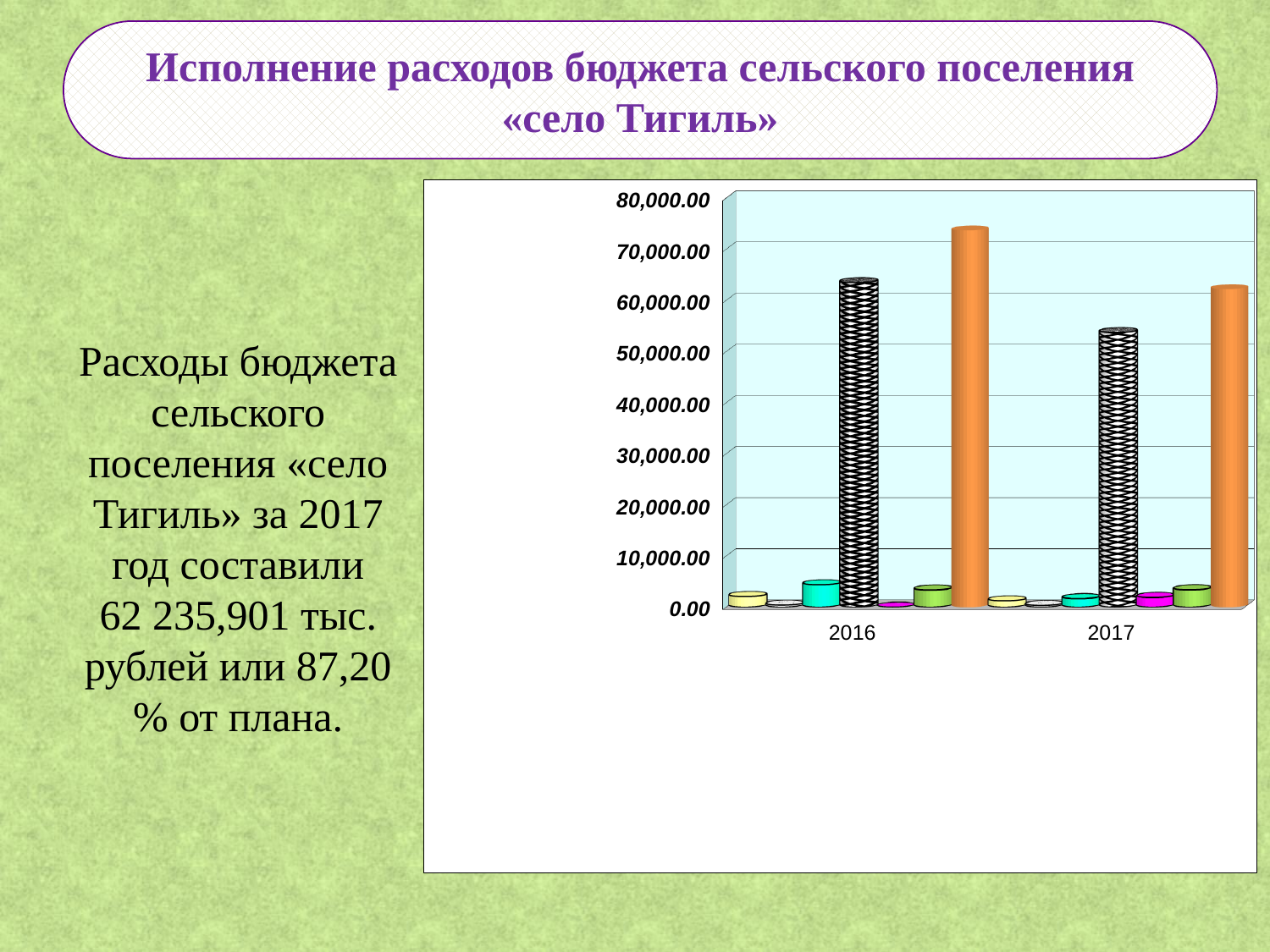
How many categories (years) are shown on the x axis of the chart? 2 What is the highest value labelled on the vertical axis of the chart? 80,000.00 Which year has the larger value for the orange bar, 2016 or 2017? 2016 Is the value of the orange bar for 2017 greater or less than 60,000.00? greater Does the value of the orange bar rise or fall from 2016 to 2017? fall Which bar in the chart is the tallest overall? the orange bar for 2016 How many bars are plotted for each year in the chart? 7 Is the value of the tallest orange bar for 2016 greater or less than 70,000.00? greater Which year has the larger value for the black patterned bar, 2016 or 2017? 2016 Is the value of the black patterned bar for 2016 greater or less than 70,000.00? less What kind of chart is shown on the slide? bar chart